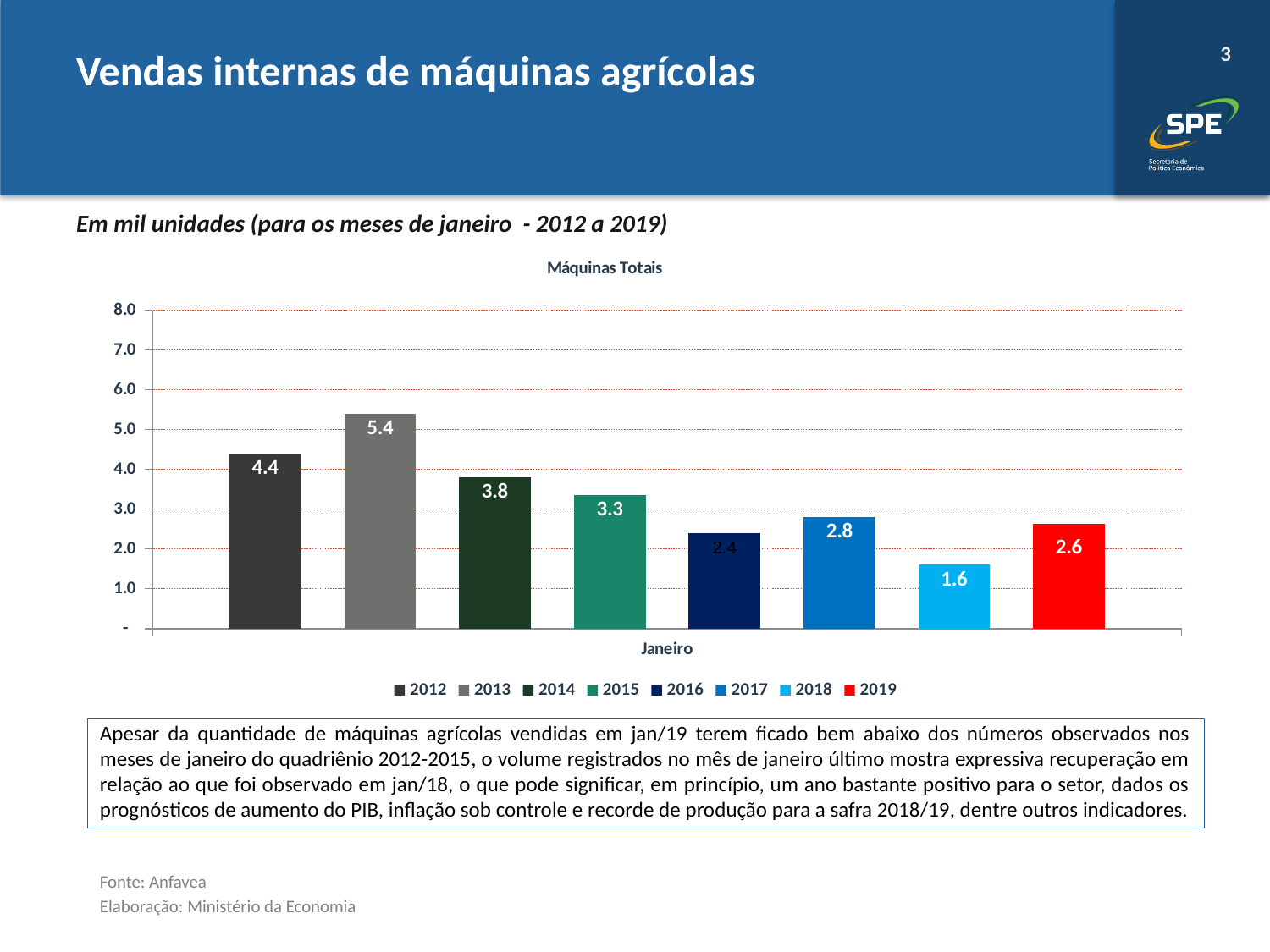
Which year has the highest value in the Máquinas Totais chart? 2013 What is the value for 2019 in the Máquinas Totais chart? 2.6 What is the value for 2018 in the Máquinas Totais chart? 1.6 What is the title of the chart? Máquinas Totais What kind of chart is shown on the slide? bar chart How many series does the legend list? 8 What is the difference between the values for 2013 and 2012? 1.0 Which year has the lowest value in the Máquinas Totais chart? 2018 Is the value for 2014 greater or less than 3.0? greater Which is larger, the value for 2017 or the value for 2016? 2017 What is the difference between the values for 2019 and 2018? 1.0 What is the value for 2013 in the Máquinas Totais chart? 5.4